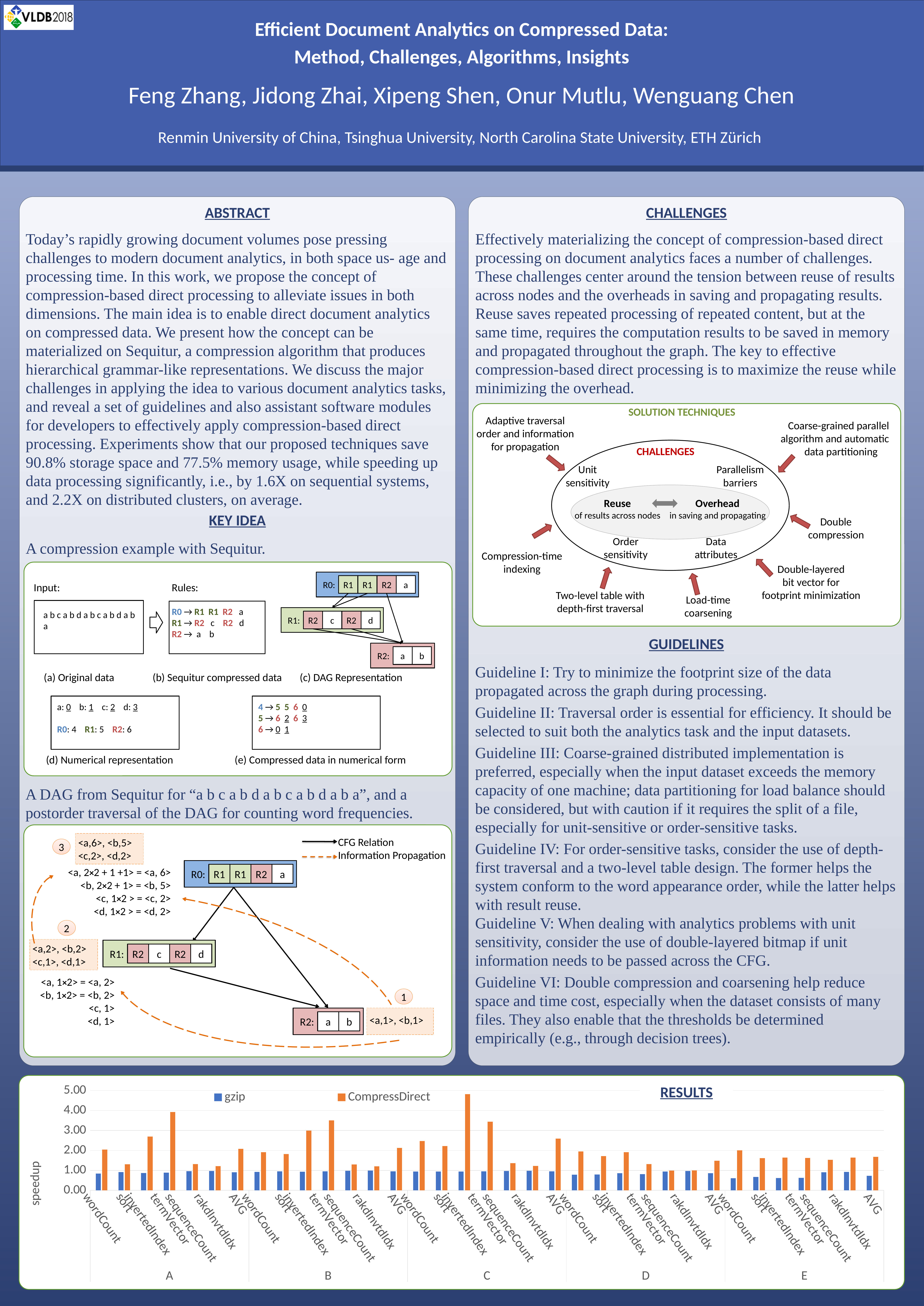
In the RESULTS chart, is the CompressDirect value for termVector in group C greater or less than 4.00? less In the RESULTS chart, is the gzip value for wordCount in group A greater or less than 1.00? less What kind of chart is shown in the RESULTS section? bar chart In the RESULTS chart, is the CompressDirect value for sequenceCount in group A greater or less than 3.00? less In the RESULTS chart, which has the larger CompressDirect speedup in group C: termVector or sequenceCount? termVector What is the label of the y axis of the RESULTS chart? speedup What are the two series named in the legend of the RESULTS chart? gzip and CompressDirect In the RESULTS chart, for wordCount in group A, which series has the larger speedup, gzip or CompressDirect? CompressDirect How many dataset groups (A, B, C, ...) are shown along the x axis of the RESULTS chart? 5 How many series does the legend of the RESULTS chart list? 2 In the RESULTS chart, which category has the highest CompressDirect speedup? invertedIndex in group C How many categories (bar pairs) are plotted in total on the RESULTS chart? 35